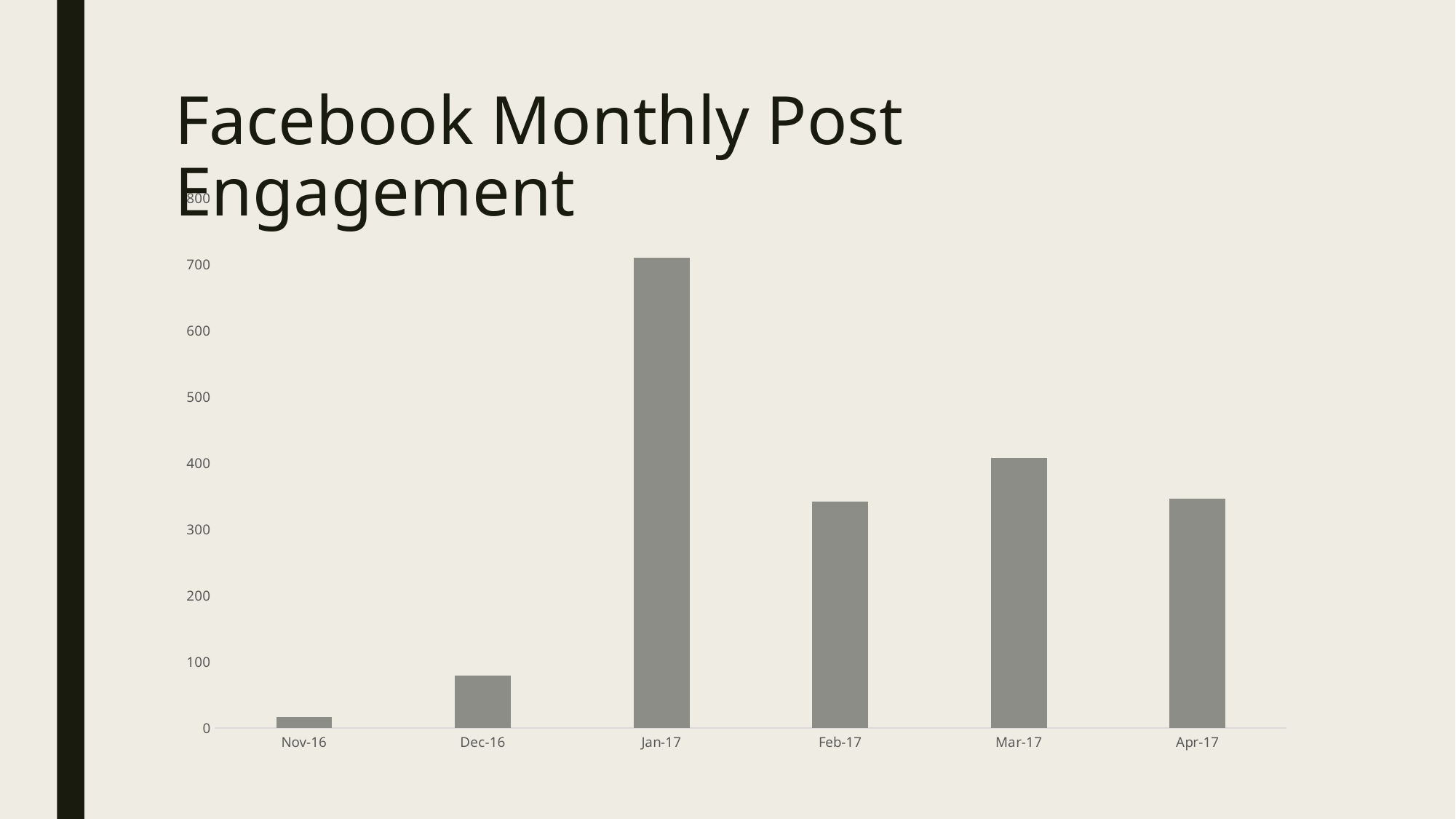
Which is larger, the value for Mar-17 or the value for Feb-17? Mar-17 Which month has the highest post engagement? Jan-17 How many months are shown on the x axis of the chart? 6 Is the value for Dec-16 greater or less than 100? less What kind of chart is shown on the slide? bar chart Is the value for Jan-17 greater or less than 700? greater Do the values rise or fall from Nov-16 to Jan-17? rise What is the title of the slide containing the chart? Facebook Monthly Post Engagement Which month has the lowest post engagement? Nov-16 Is the value for Feb-17 greater or less than 300? greater Which is larger, the value for Dec-16 or the value for Nov-16? Dec-16